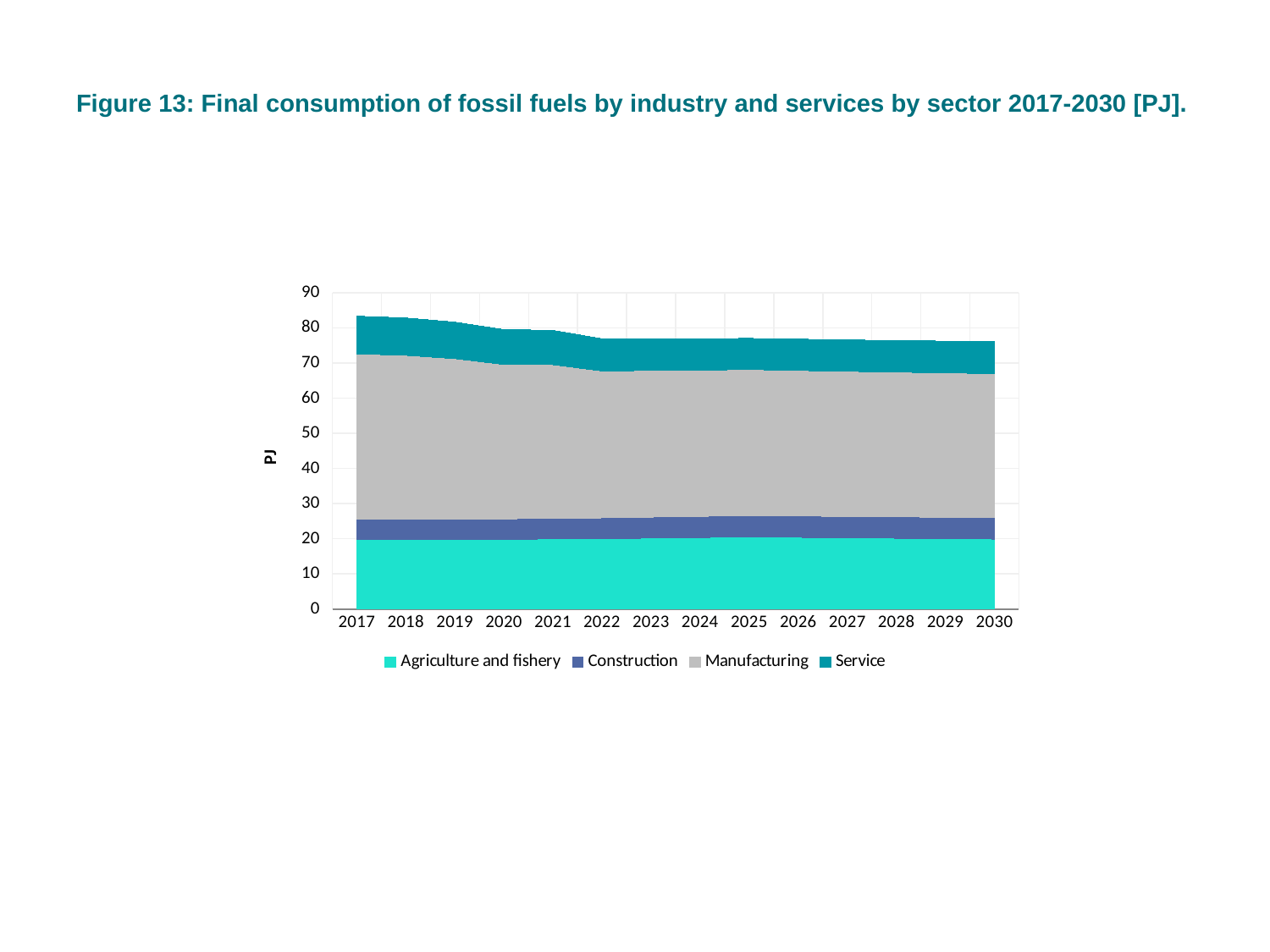
Is the total consumption in 2025 greater or less than 80 PJ? less Is the total consumption in 2030 greater or less than 80 PJ? less Which sector accounts for the largest share of consumption across the period? Manufacturing Which is larger, the total consumption in 2017 or in 2030? 2017 Does the total final consumption of fossil fuels rise or fall from 2017 to 2030? fall Which sector accounts for the smallest share of consumption across the period? Construction How many series does the legend list? 4 Which year has the highest total final consumption of fossil fuels? 2017 What kind of chart is shown on the slide? Stacked area chart Is the total consumption in 2017 greater or less than 80 PJ? greater How many years are shown along the x axis? 14 What is the label on the vertical axis? PJ